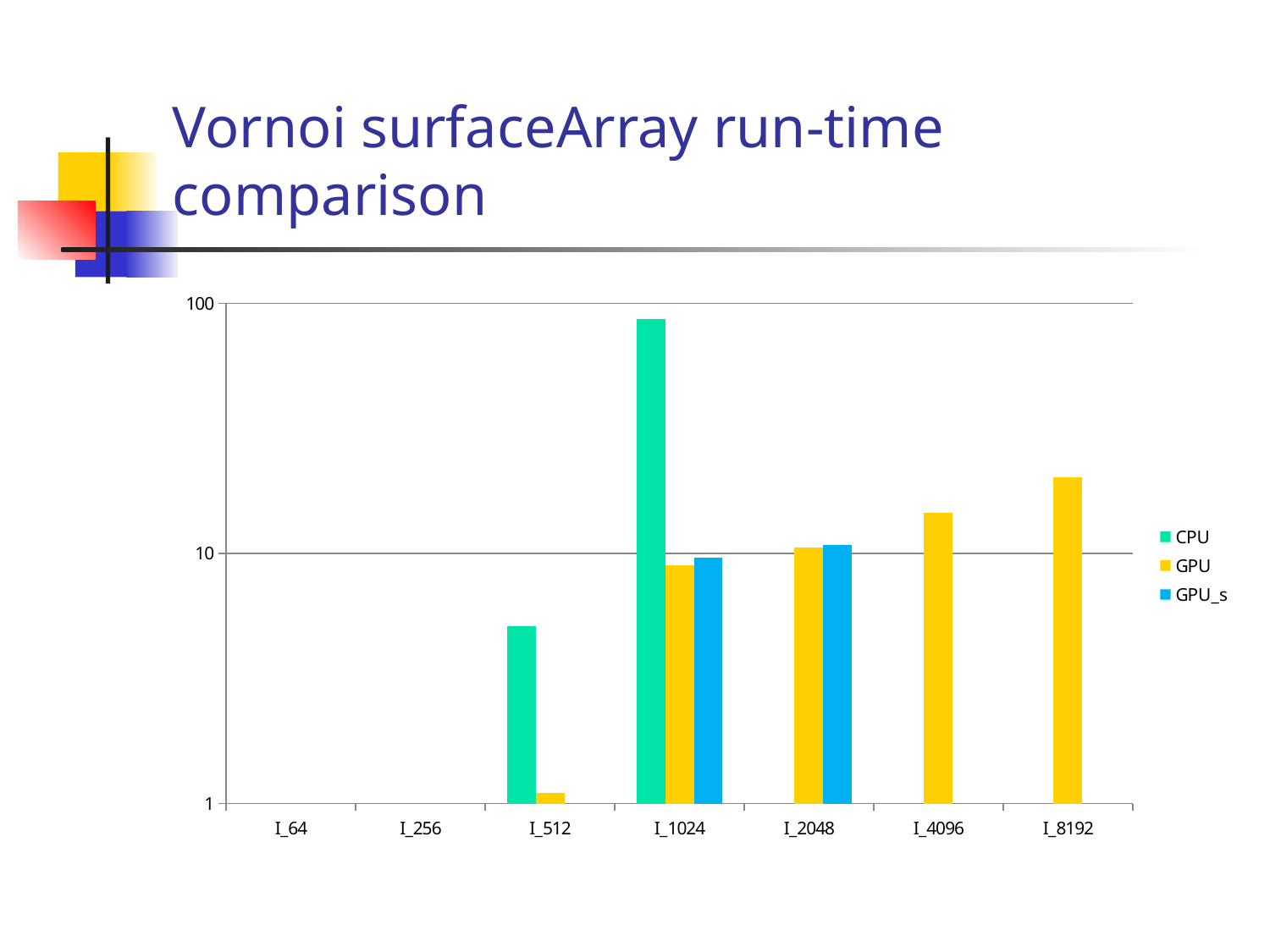
Is the GPU value for I_8192 greater or less than 10? greater For I_1024, which is larger, the CPU value or the GPU value? CPU Is the CPU value for I_512 greater or less than 10? less Do the GPU values rise or fall from I_512 to I_8192? rise How many categories are shown on the x axis? 7 How many series does the legend list? 3 Is the GPU value for I_4096 greater or less than 10? greater Which category has the highest CPU value? I_1024 What is the title of the slide containing the chart? Vornoi surfaceArray run-time comparison Which category has the highest GPU value? I_8192 What kind of chart is shown on the slide? bar chart